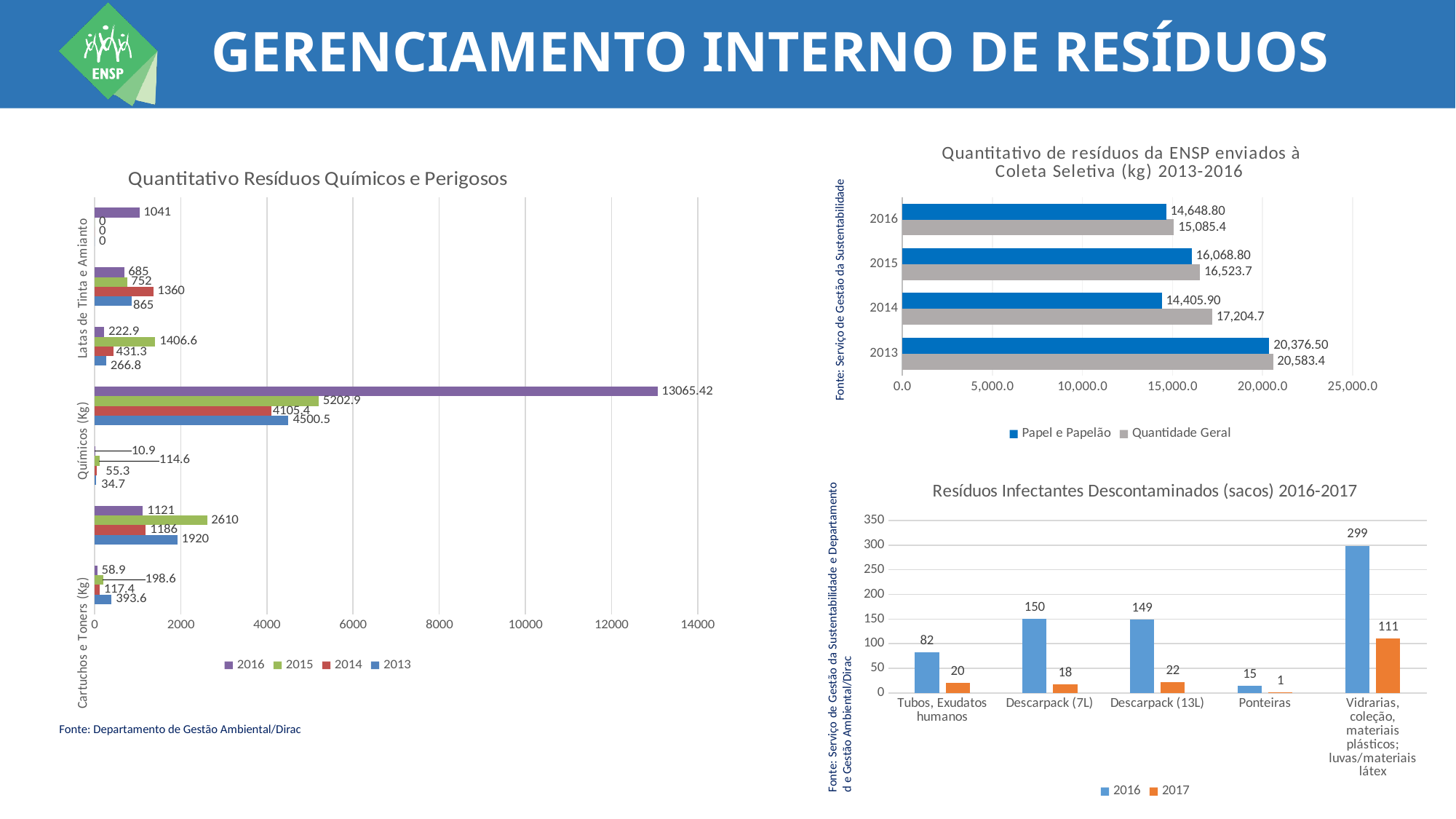
In the chart 'Quantitativo de resíduos da ENSP enviados à Coleta Seletiva (kg) 2013-2016', which year has the highest Quantidade Geral value? 2013 In the chart 'Resíduos Infectantes Descontaminados (sacos) 2016-2017', what is the 2016 value for Descarpack (7L)? 150 In the chart 'Quantitativo de resíduos da ENSP enviados à Coleta Seletiva (kg) 2013-2016', what is the Quantidade Geral value for 2014? 17,204.7 In the chart 'Quantitativo de resíduos da ENSP enviados à Coleta Seletiva (kg) 2013-2016', which year has the lowest Papel e Papelão value? 2014 In the chart 'Quantitativo de resíduos da ENSP enviados à Coleta Seletiva (kg) 2013-2016', how many series does the legend list? 2 In the chart 'Quantitativo de resíduos da ENSP enviados à Coleta Seletiva (kg) 2013-2016', what is the value for Papel e Papelão in 2013? 20,376.50 In the chart 'Quantitativo Resíduos Químicos e Perigosos', what is the largest value shown on any bar? 13065.42 In the chart 'Resíduos Infectantes Descontaminados (sacos) 2016-2017', how many categories are shown on the x axis? 5 In the chart 'Resíduos Infectantes Descontaminados (sacos) 2016-2017', which category has the highest 2016 value? Vidrarias, coleção, materiais plásticos; luvas/materiais látex In the chart 'Resíduos Infectantes Descontaminados (sacos) 2016-2017', what is the difference between the 2016 and 2017 values for Tubos, Exudatos humanos? 62 In the chart 'Resíduos Infectantes Descontaminados (sacos) 2016-2017', what is the 2017 value for Ponteiras? 1 What kind of chart is 'Quantitativo Resíduos Químicos e Perigosos'? Bar chart